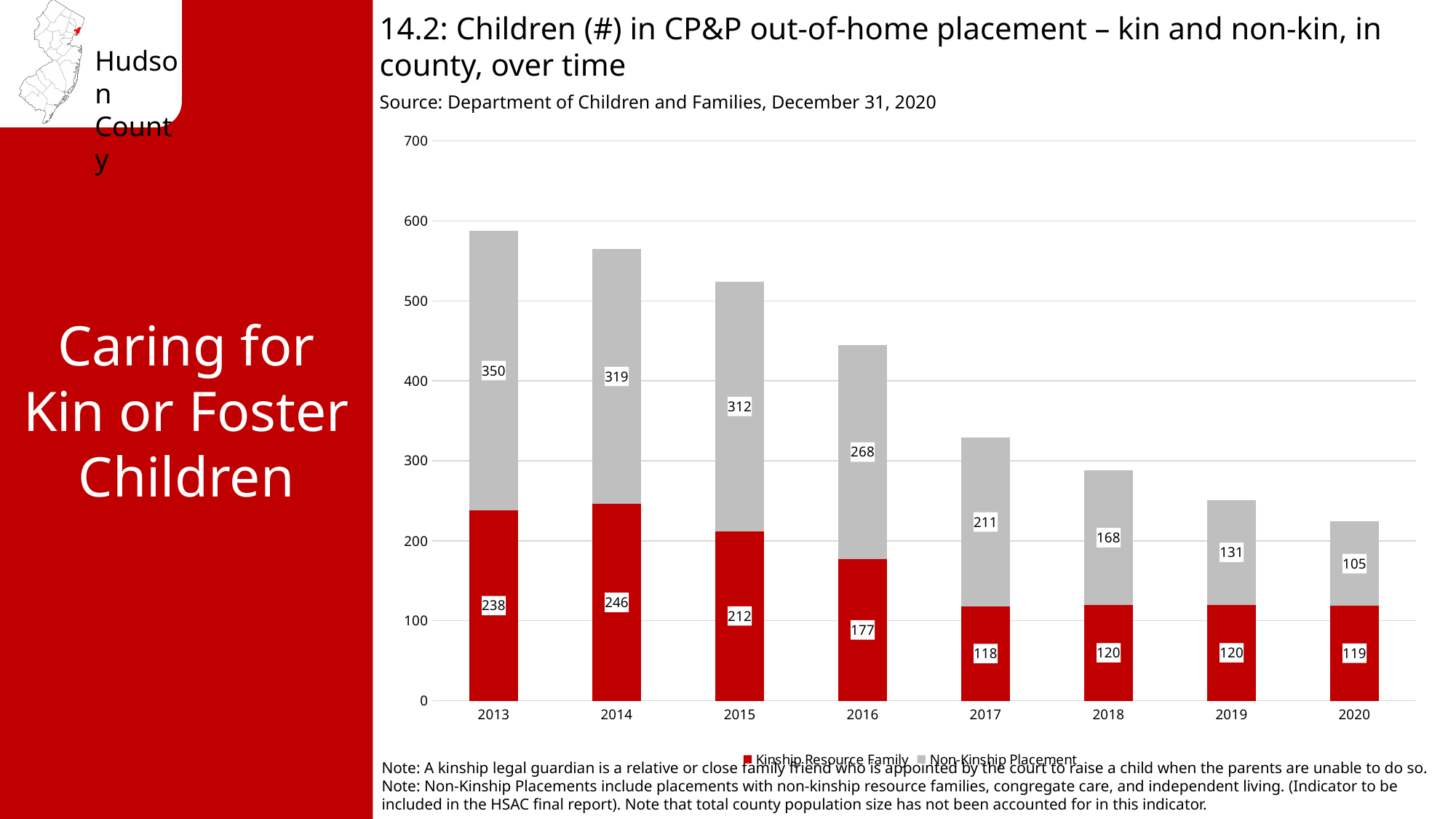
What is the total of the stacked bar for 2019? 251 Which is larger in 2020, the Kinship Resource Family value or the Non-Kinship Placement value? Kinship Resource Family What is the Non-Kinship Placement value for 2018? 168 How many years are shown on the x axis? 8 What is the Kinship Resource Family value for 2013? 238 How many series does the legend list? 2 Which year has the lowest Kinship Resource Family value? 2017 What is the total of the stacked bar for 2016? 445 What is the Non-Kinship Placement value for 2020? 105 What is the difference between the Non-Kinship Placement values for 2013 and 2014? 31 Which year has the highest Non-Kinship Placement value? 2013 What kind of chart is shown? Stacked bar chart